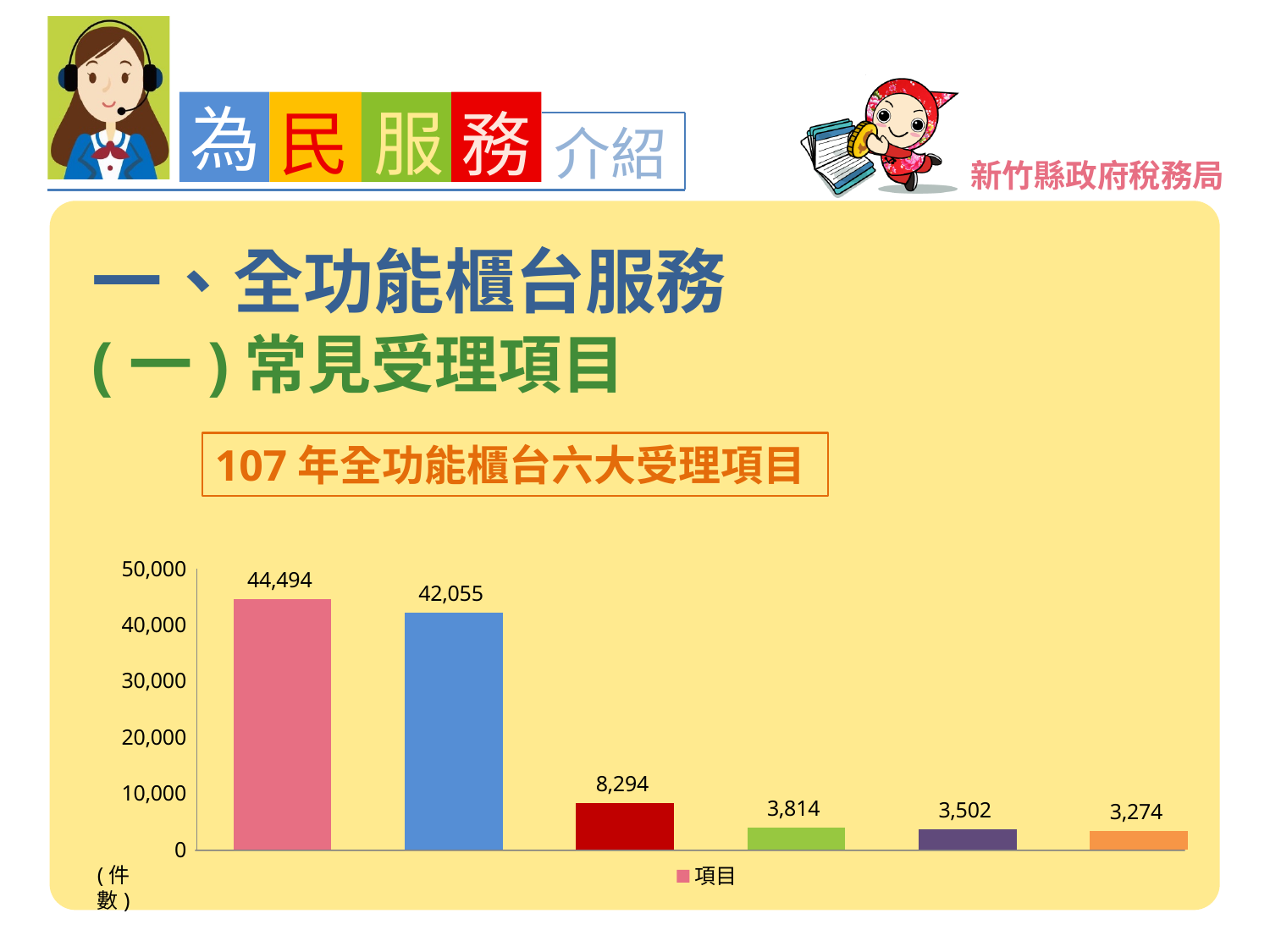
Do the bar values rise or fall from left to right across the chart? fall What is the title shown above the chart? 107 年全功能櫃台六大受理項目 What type of chart is shown on the slide? bar chart How many bars are plotted in the chart? 6 What is the difference between the pink bar (44,494) and the blue bar (42,055)? 2,439 Which is larger, the purple bar (fifth from the left) or the orange bar (far right)? the purple bar (3,502) How many series does the legend list? 1 What is the value of the dark red bar (third from the left)? 8,294 What is the value of the blue bar (second from the left)? 42,055 What is the value of the tallest bar (the pink bar on the far left)? 44,494 What is the value of the green bar (fourth from the left)? 3,814 What is the value of the shortest bar (the orange bar on the far right)? 3,274